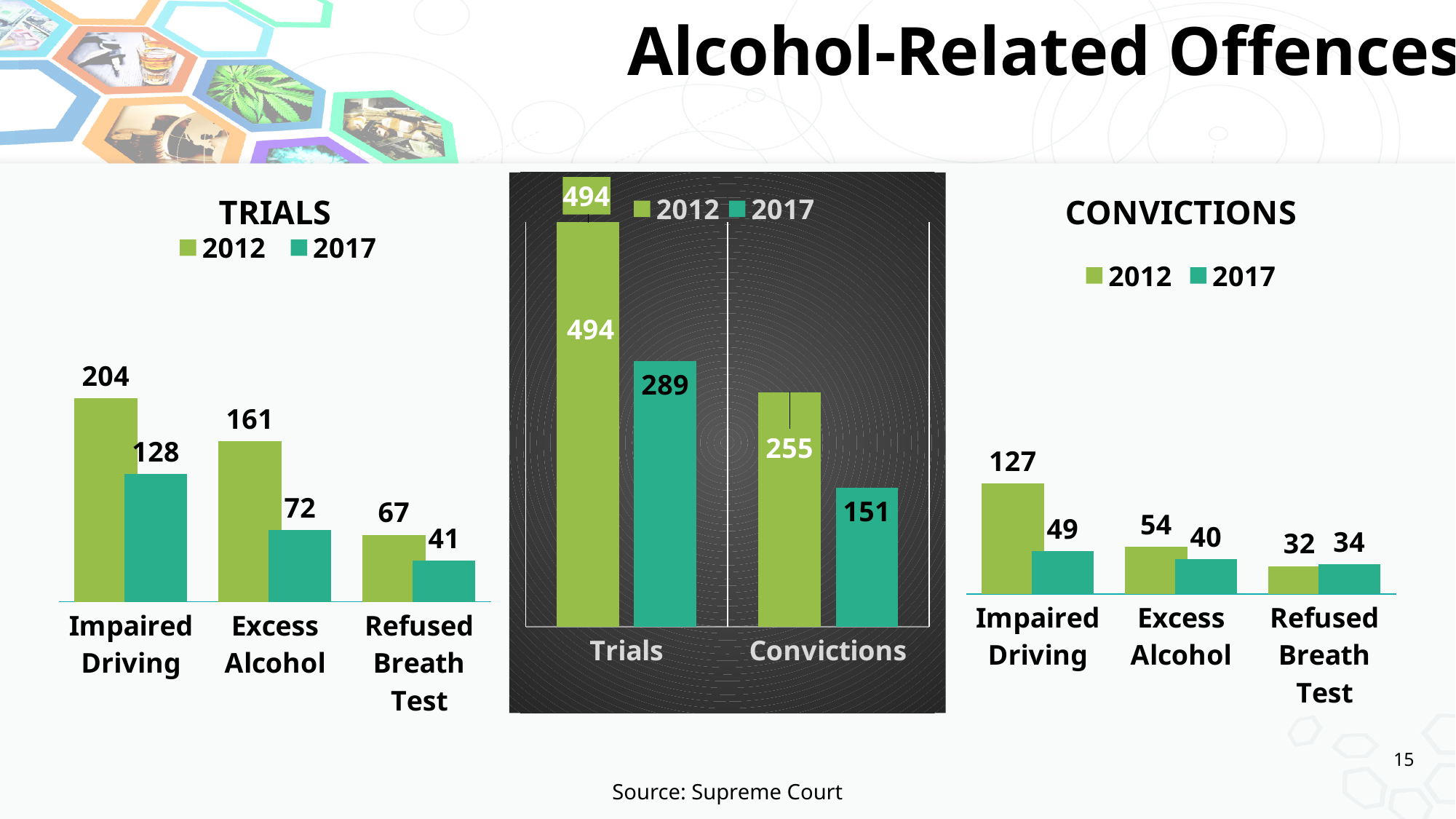
In the TRIALS chart, what is the difference between the 2012 and 2017 values for Impaired Driving? 76 How many series does the legend of the CONVICTIONS chart list? 2 In the CONVICTIONS chart, what is the value for Refused Breath Test in 2017? 34 In the middle chart, what is the difference between Trials in 2012 and Trials in 2017? 205 In the TRIALS chart, what is the value for Excess Alcohol in 2017? 72 In the CONVICTIONS chart, which is larger for Refused Breath Test: the 2012 value or the 2017 value? 2017 In the middle chart, what is the value for Convictions in 2017? 151 In the CONVICTIONS chart, which category has the highest value in 2012? Impaired Driving What kind of chart is the TRIALS chart? Bar chart In the middle chart, which is larger: Trials in 2017 or Convictions in 2012? Trials in 2017 In the TRIALS chart, which category has the lowest value in 2017? Refused Breath Test In the TRIALS chart, what is the value for Impaired Driving in 2012? 204